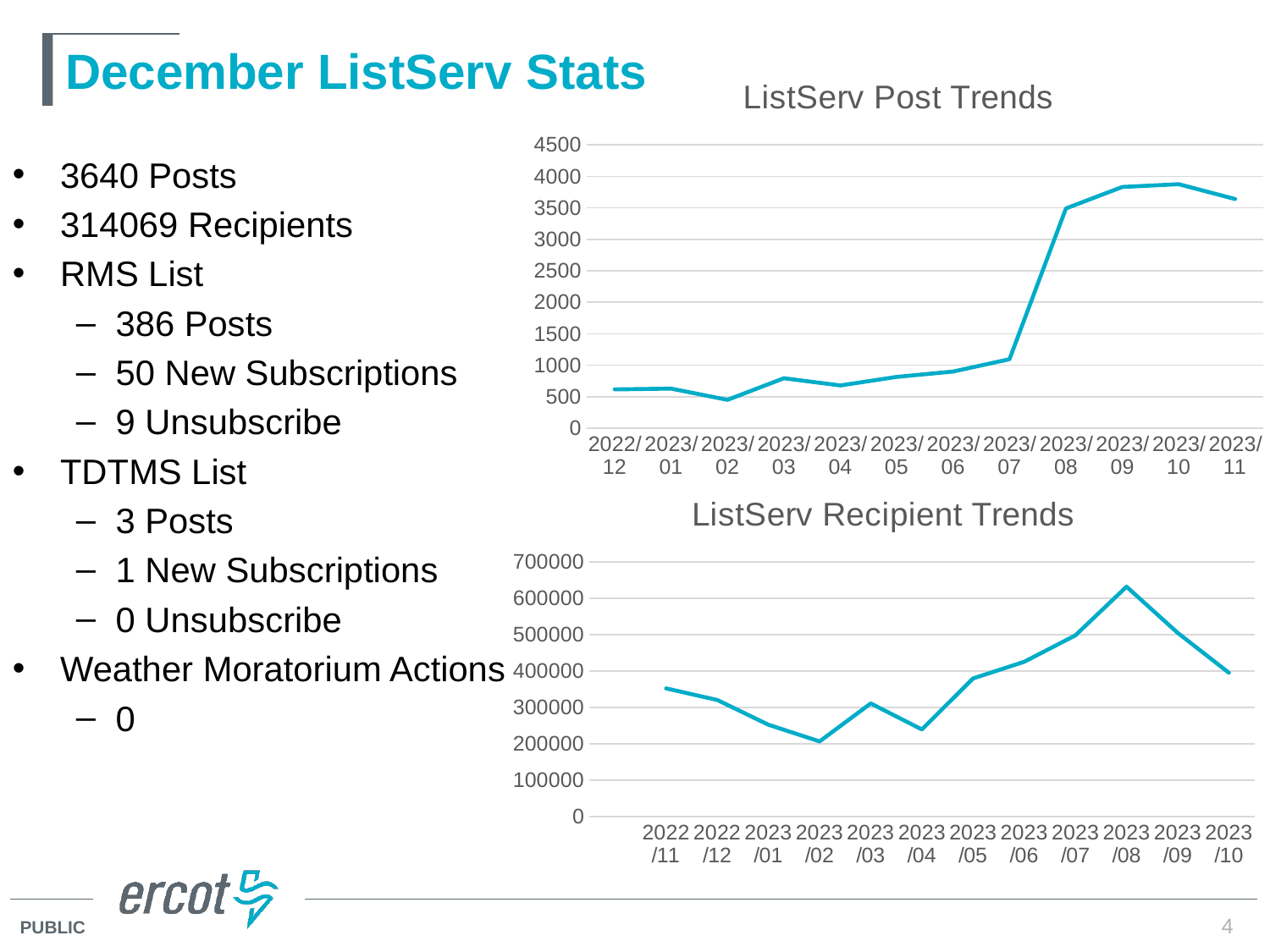
How many months are plotted on the "ListServ Recipient Trends" chart? 12 On the "ListServ Recipient Trends" chart, is the value for 2023/08 greater or less than 600000? greater On the "ListServ Recipient Trends" chart, which is larger, the value for 2023/03 or the value for 2023/04? 2023/03 On the "ListServ Post Trends" chart, is the value for 2023/07 greater or less than 1500? less What kind of chart is the "ListServ Recipient Trends" chart? line chart How many months are plotted on the "ListServ Post Trends" chart? 12 On the "ListServ Recipient Trends" chart, which month has the lowest value? 2023/02 On the "ListServ Post Trends" chart, is the value for 2023/08 greater or less than 3000? greater On the "ListServ Post Trends" chart, which month has the lowest value? 2023/02 What kind of chart is the "ListServ Post Trends" chart? line chart On the "ListServ Post Trends" chart, which is larger, the value for 2023/07 or the value for 2023/08? 2023/08 On the "ListServ Recipient Trends" chart, which month has the highest value? 2023/08